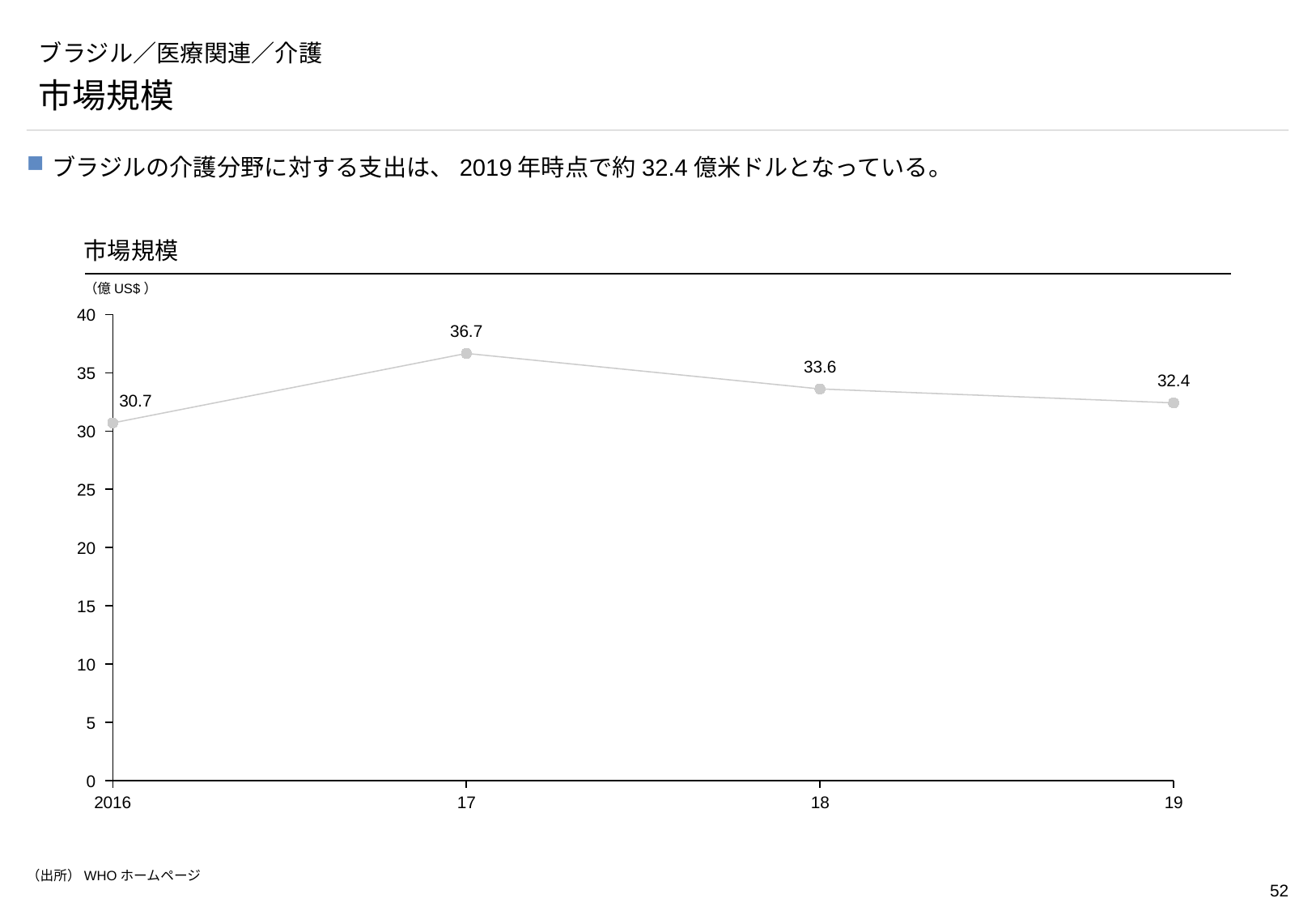
What is the market size value for 19 (2019)? 32.4 What unit is shown for the y axis of the chart? 億US$ How many data points are plotted on the chart? 4 What kind of chart is shown on the slide? line chart What is the market size value for 2016? 30.7 Which year has the lowest market size? 2016 Which is larger, the market size in 18 or in 19? 18 What is the difference between the market size in 17 and in 2016? 6.0 Which year has the highest market size? 17 What is the market size value for 18 (2018)? 33.6 What is the market size value for 17 (2017)? 36.7 Is the value for 2016 greater or less than 35? less